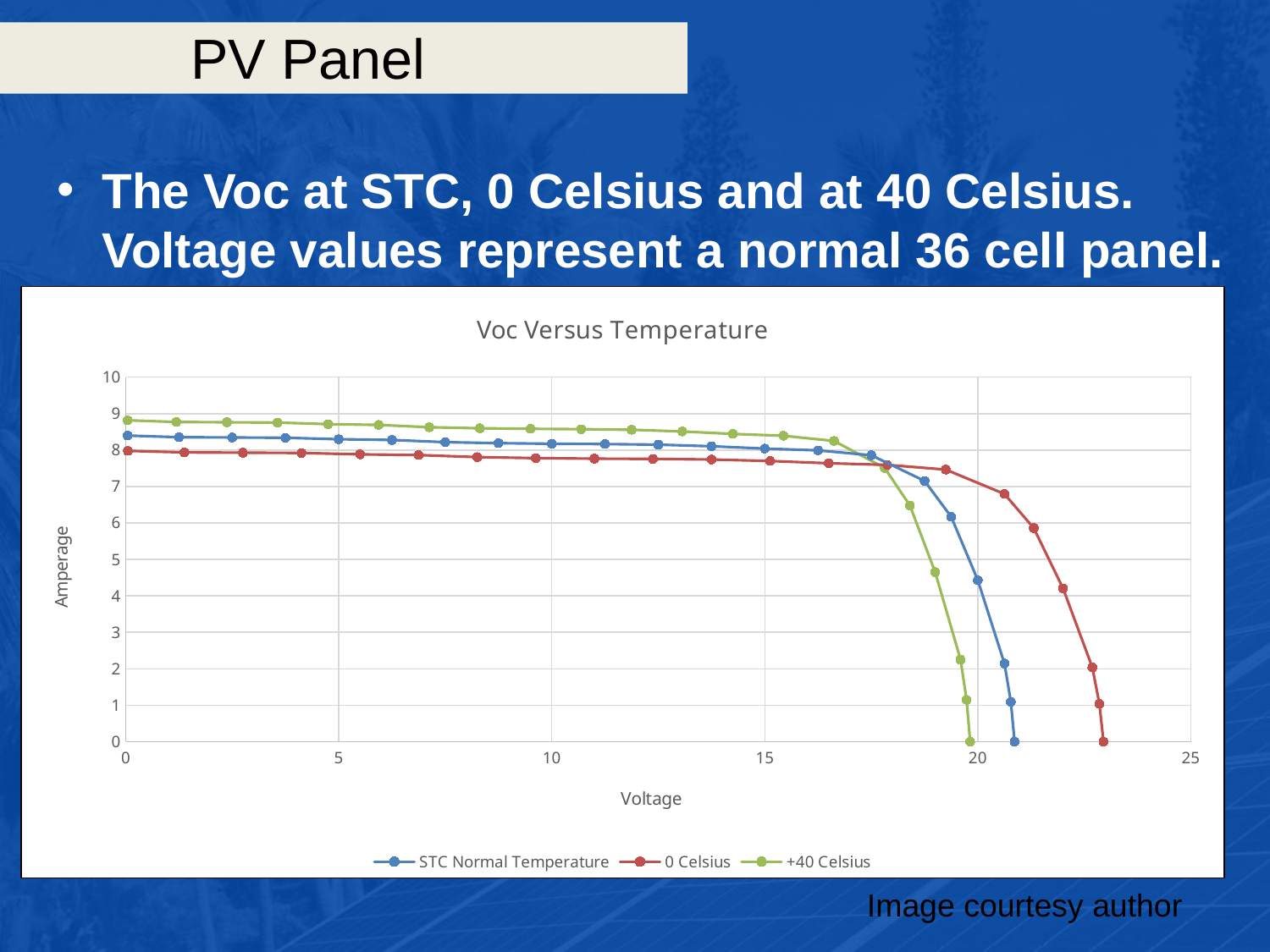
What kind of chart is shown on the slide? line chart At a voltage of 0, which series has the highest amperage? +40 Celsius Which series reaches 0 amperage at the highest voltage? 0 Celsius At a voltage of 0, is the amperage for +40 Celsius greater or less than 8? greater How many series does the legend list? 3 At a voltage of 0, is the amperage for 0 Celsius greater or less than 9? less What is the title of the chart? Voc Versus Temperature What label is on the vertical axis of the chart? Amperage Which series drops to 0 amperage at a higher voltage, STC Normal Temperature or +40 Celsius? STC Normal Temperature Which series reaches 0 amperage at the lowest voltage? +40 Celsius Do the amperage values rise or fall as voltage increases along the x axis? fall At a voltage of 0, which series has the lowest amperage? 0 Celsius